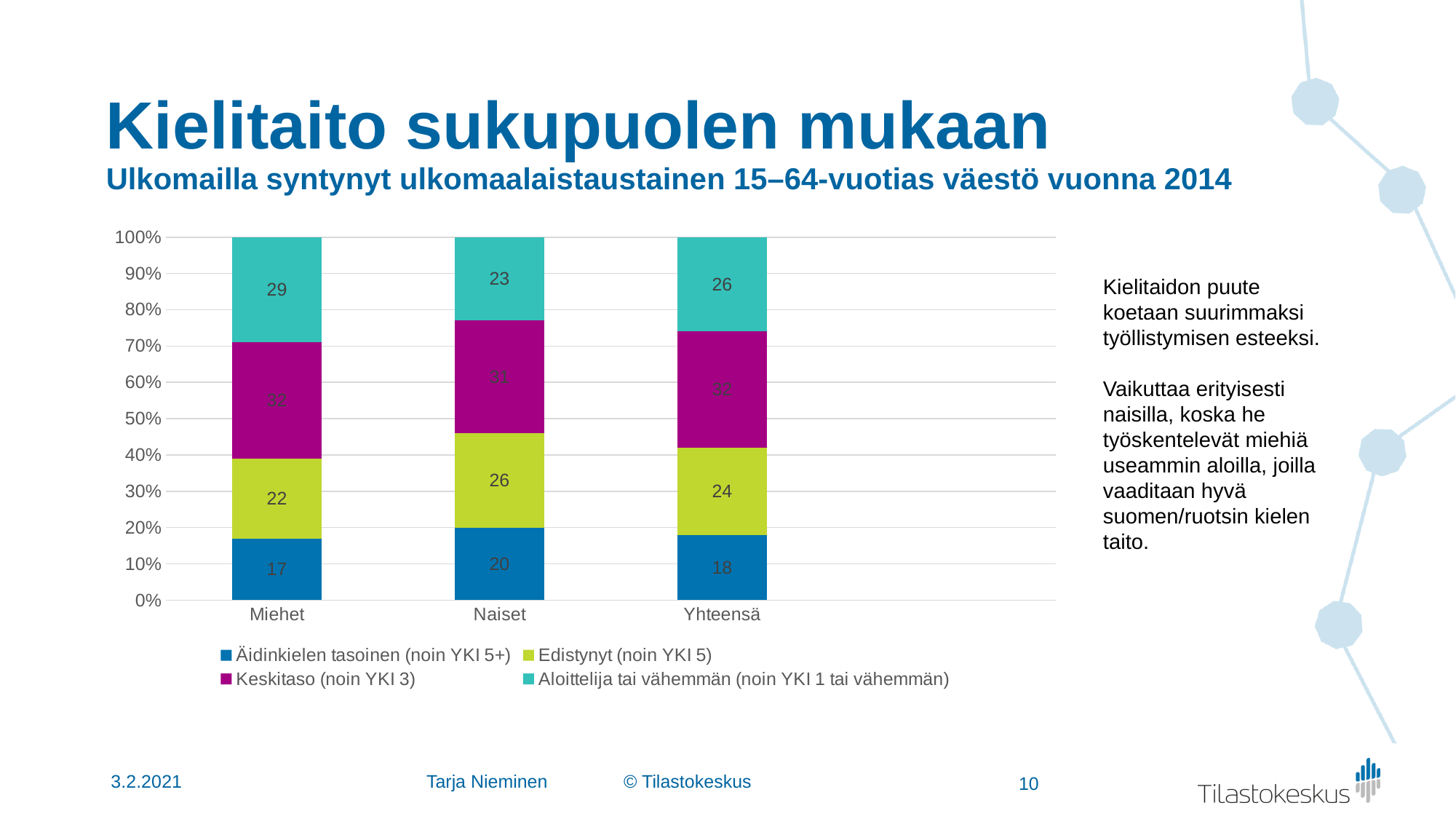
What is the difference between the 'Edistynyt (noin YKI 5)' values for Naiset and Miehet? 4 What is the value of 'Aloittelija tai vähemmän (noin YKI 1 tai vähemmän)' for Miehet? 29 What is the value of 'Äidinkielen tasoinen (noin YKI 5+)' for Naiset? 20 How many series does the chart legend list? 4 Which is larger: the 'Aloittelija tai vähemmän (noin YKI 1 tai vähemmän)' value for Miehet or for Naiset? Miehet Which category has the highest value for 'Aloittelija tai vähemmän (noin YKI 1 tai vähemmän)'? Miehet What kind of chart is shown on the slide? Stacked bar chart Which category has the lowest value for 'Äidinkielen tasoinen (noin YKI 5+)'? Miehet What is the value of 'Edistynyt (noin YKI 5)' for Yhteensä? 24 Which series is shown in purple in the chart? Keskitaso (noin YKI 3) How many categories are shown on the x axis of the chart? 3 What is the value of 'Keskitaso (noin YKI 3)' for Naiset? 31